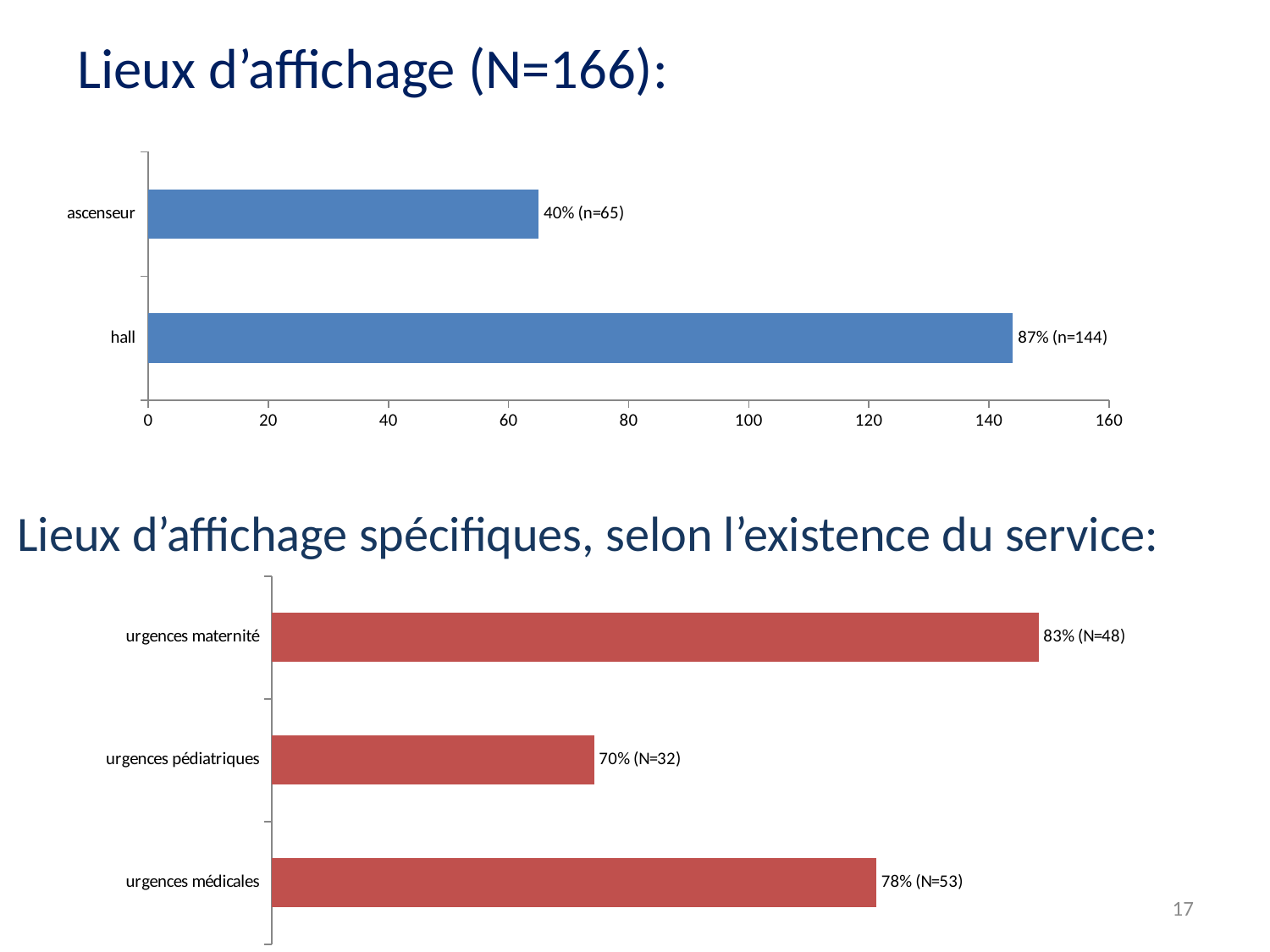
In the top chart 'Lieux d'affichage (N=166)', how many categories are shown? 2 In the top chart 'Lieux d'affichage (N=166)', what is the data label for 'hall'? 87% (n=144) In the bottom chart 'Lieux d'affichage spécifiques, selon l'existence du service', which category has the lowest percentage? urgences pédiatriques In the bottom chart 'Lieux d'affichage spécifiques, selon l'existence du service', which category has the highest percentage? urgences maternité In the bottom chart 'Lieux d'affichage spécifiques, selon l'existence du service', what is the data label for 'urgences pédiatriques'? 70% (N=32) In the top chart 'Lieux d'affichage (N=166)', is the bar for 'ascenseur' greater or less than 80 on the axis? less In the top chart 'Lieux d'affichage (N=166)', what is the difference in counts between 'hall' (n=144) and 'ascenseur' (n=65)? 79 In the top chart 'Lieux d'affichage (N=166)', what is the data label for 'ascenseur'? 40% (n=65) In the bottom chart 'Lieux d'affichage spécifiques, selon l'existence du service', what is the data label for 'urgences médicales'? 78% (N=53) In the bottom chart 'Lieux d'affichage spécifiques, selon l'existence du service', what is the difference in percentage points between 'urgences maternité' and 'urgences pédiatriques'? 13 In the top chart 'Lieux d'affichage (N=166)', which category has the highest value? hall What kind of chart is the top chart 'Lieux d'affichage (N=166)'? bar chart